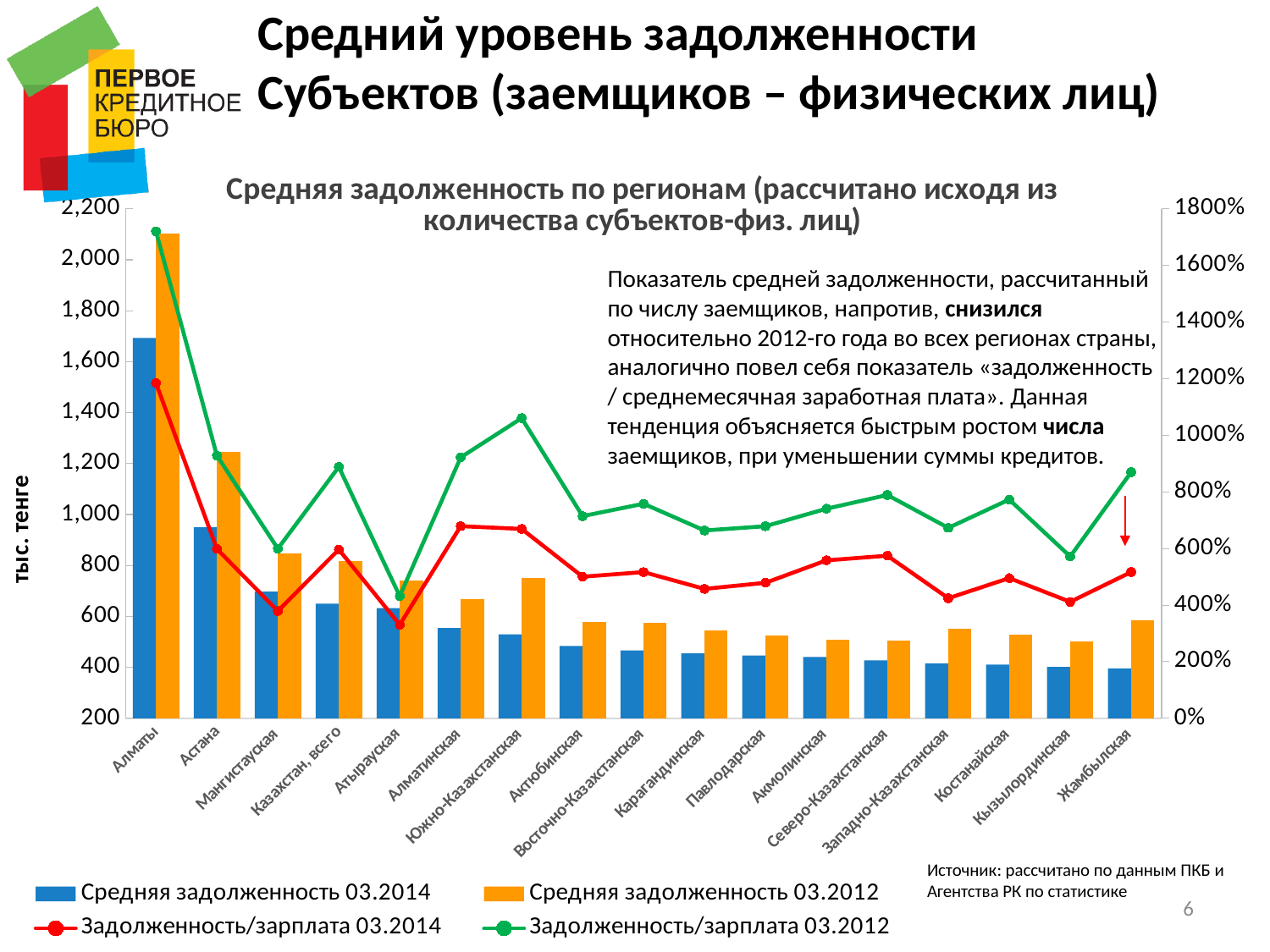
Is the value of Средняя задолженность 03.2014 for Астана greater or less than 1,000? less Which region has the highest value for Средняя задолженность 03.2014? Алматы What is the label of the left vertical axis? тыс. тенге Do the Средняя задолженность 03.2014 bars generally rise or fall from left to right along the x axis? fall How many series does the chart legend list? 4 Which region has the highest value for Средняя задолженность 03.2012? Алматы Is the value of Средняя задолженность 03.2012 for Алматы greater or less than 2,000? greater What kind of chart is shown on the slide? A combined bar and line chart How many regions (categories) are shown along the x axis? 17 Which region has the lowest value on the Задолженность/зарплата 03.2014 line? Атырауская For Алматы, which is larger: Средняя задолженность 03.2012 or Средняя задолженность 03.2014? Средняя задолженность 03.2012 Which region has the lowest value on the Задолженность/зарплата 03.2012 line? Атырауская